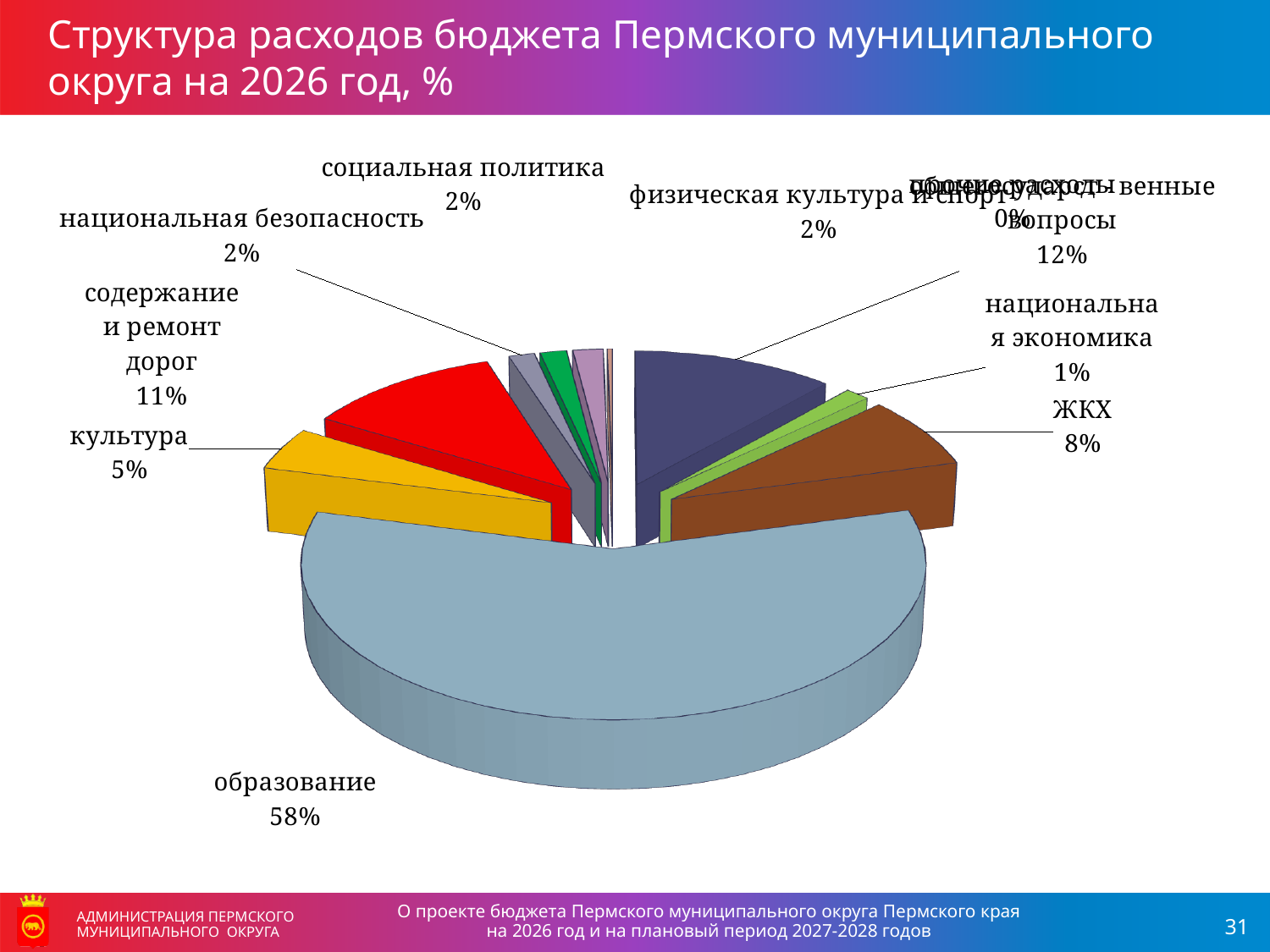
What percentage is shown for содержание и ремонт дорог? 11% What percentage is shown for ЖКХ? 8% What percentage is shown for национальная экономика? 1% Which has a larger share, ЖКХ or культура? ЖКХ What percentage is shown for культура? 5% What percentage is shown for национальная безопасность? 2% Which category has the largest share of the budget expenditures? образование What is the difference in percentage points between образование and содержание и ремонт дорог? 47 What year does the chart title say the budget expenditure structure refers to? 2026 What share of the budget expenditures goes to образование? 58% What is the difference in percentage points between ЖКХ and культура? 3 What kind of chart is shown on the slide? pie chart